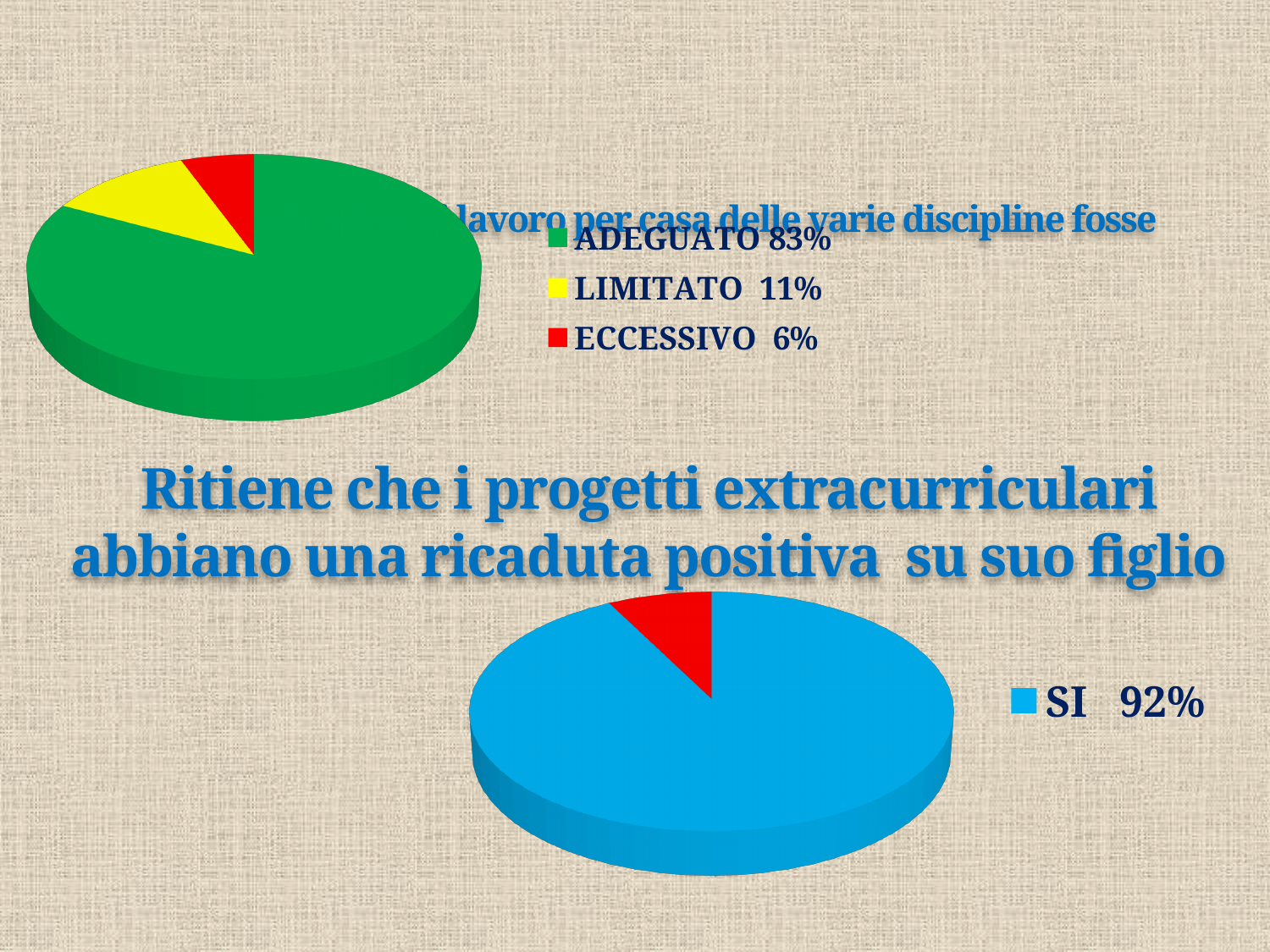
How many categories does the legend of the top pie chart list? 3 In the top pie chart, what is the difference in percentage points between ADEGUATO and LIMITATO? 72 In the top pie chart, which category has the largest share? ADEGUATO In the top pie chart, which category has the smallest share? ECCESSIVO In the top pie chart, what colour is the ADEGUATO slice? green What kind of chart is the top chart on the slide? pie chart In the top pie chart, what percentage is shown for ECCESSIVO? 6% In the bottom pie chart, what percentage is shown for SI? 92% In the top pie chart, which is larger, LIMITATO or ECCESSIVO? LIMITATO In the top pie chart, what percentage is shown for LIMITATO? 11% In the top pie chart, what percentage is shown for ADEGUATO? 83% How many slices does the bottom pie chart show? 2